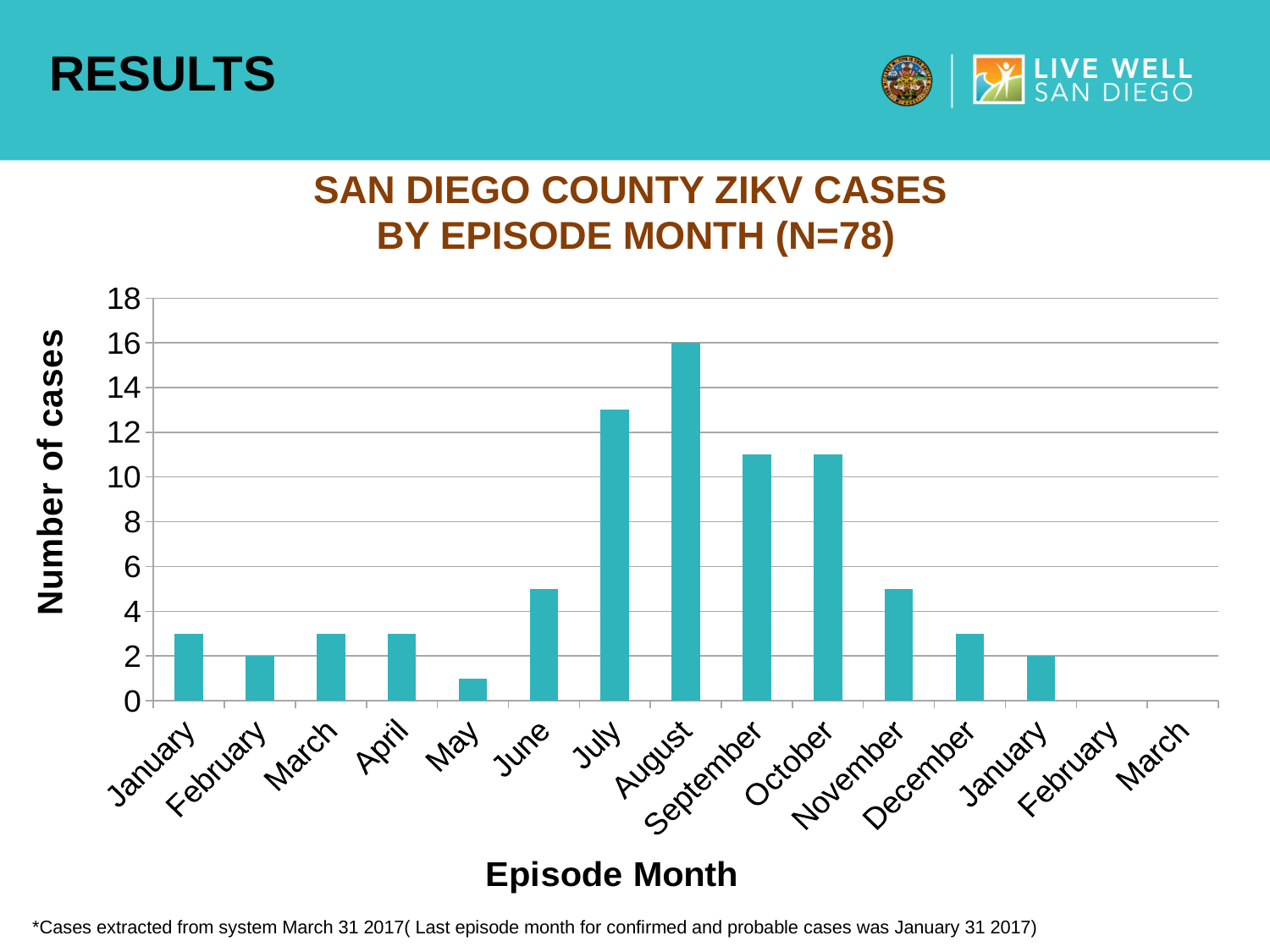
What type of chart is shown on the slide? bar chart What is the difference in number of cases between August and the first February? 14 How many episode months are shown on the x axis? 15 Do the number of cases rise or fall from June to August? rise Is the number of cases for June greater or less than 6? less How many cases are shown for the first February on the x axis? 2 Which episode month has the highest number of cases? August Is the number of cases for September greater or less than 10? greater What is the label of the y axis? Number of cases Which has more cases, July or September? July How many cases are shown for August? 16 Is the number of cases for July greater or less than 12? greater